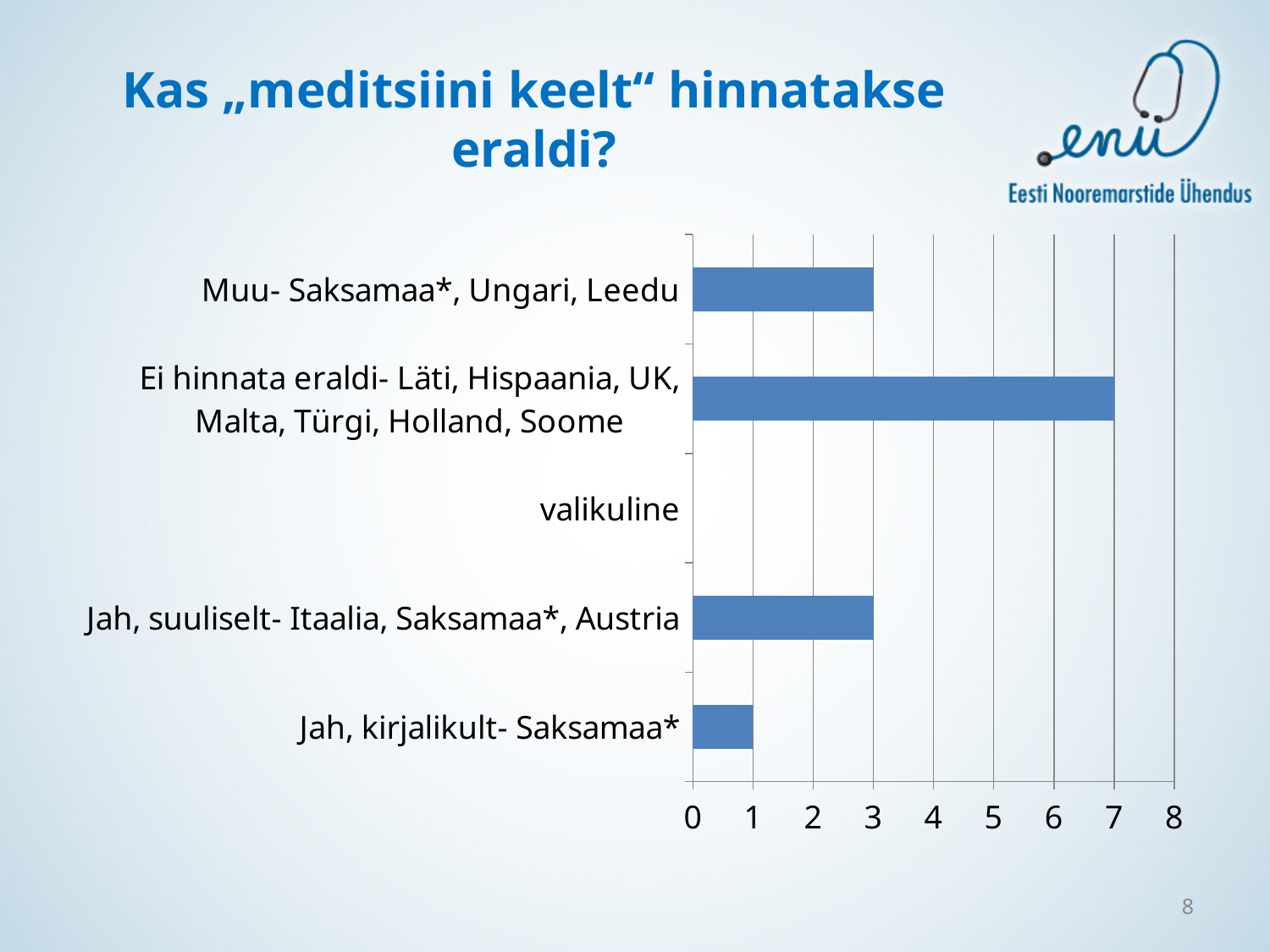
What is the highest value shown on the horizontal axis? 8 What kind of chart is shown on the slide? bar chart What is the value for "Jah, kirjalikult- Saksamaa*"? 1 How many categories are shown on the chart? 5 What is the difference between the value for "Ei hinnata eraldi" and the value for "Jah, kirjalikult- Saksamaa*"? 6 Which category has no bar at all (a value of 0)? valikuline What is the value for "Muu- Saksamaa*, Ungari, Leedu"? 3 What is the value for "Jah, suuliselt- Itaalia, Saksamaa*, Austria"? 3 Which is larger: the value for "Jah, suuliselt- Itaalia, Saksamaa*, Austria" or the value for "Jah, kirjalikult- Saksamaa*"? Jah, suuliselt- Itaalia, Saksamaa*, Austria Which category has the highest value? Ei hinnata eraldi- Läti, Hispaania, UK, Malta, Türgi, Holland, Soome What is the value for "Ei hinnata eraldi- Läti, Hispaania, UK, Malta, Türgi, Holland, Soome"? 7 Is the value for "Ei hinnata eraldi" greater or less than 5? greater